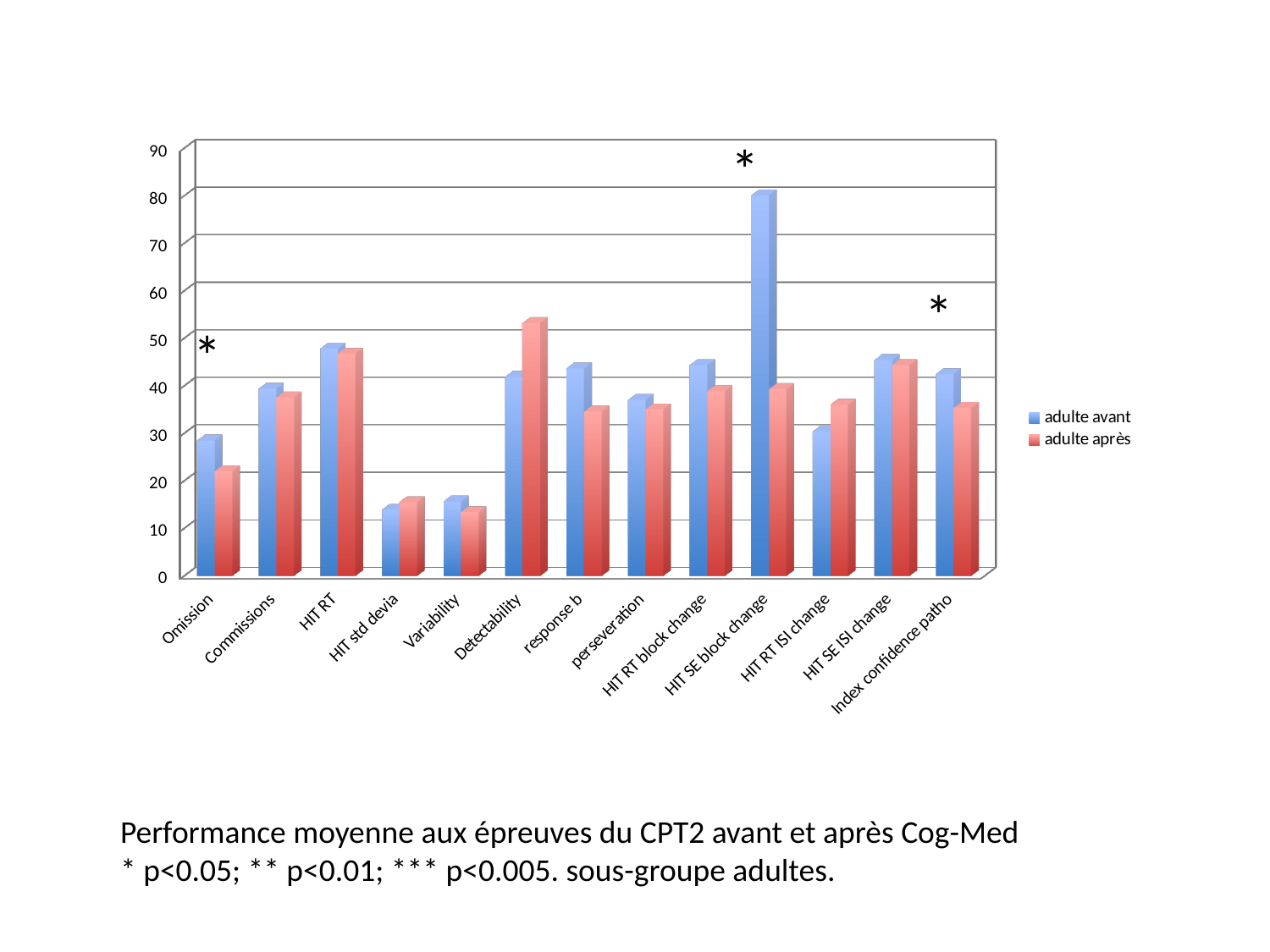
Is the 'adulte avant' value for HIT std devia greater or less than 20? less Is the 'adulte avant' value for HIT SE block change greater or less than 70? greater Which category has the highest value for the 'adulte avant' series? HIT SE block change What colour are the bars for the 'adulte avant' series? blue For response b, which series has the larger value, 'adulte avant' or 'adulte après'? adulte avant For Detectability, which series has the larger value, 'adulte avant' or 'adulte après'? adulte après What kind of chart is shown on the slide? bar chart How many series does the legend list? 2 How many categories are shown along the x axis? 13 Is the 'adulte après' value for Omission greater or less than 30? less Which category has the highest value for the 'adulte après' series? Detectability